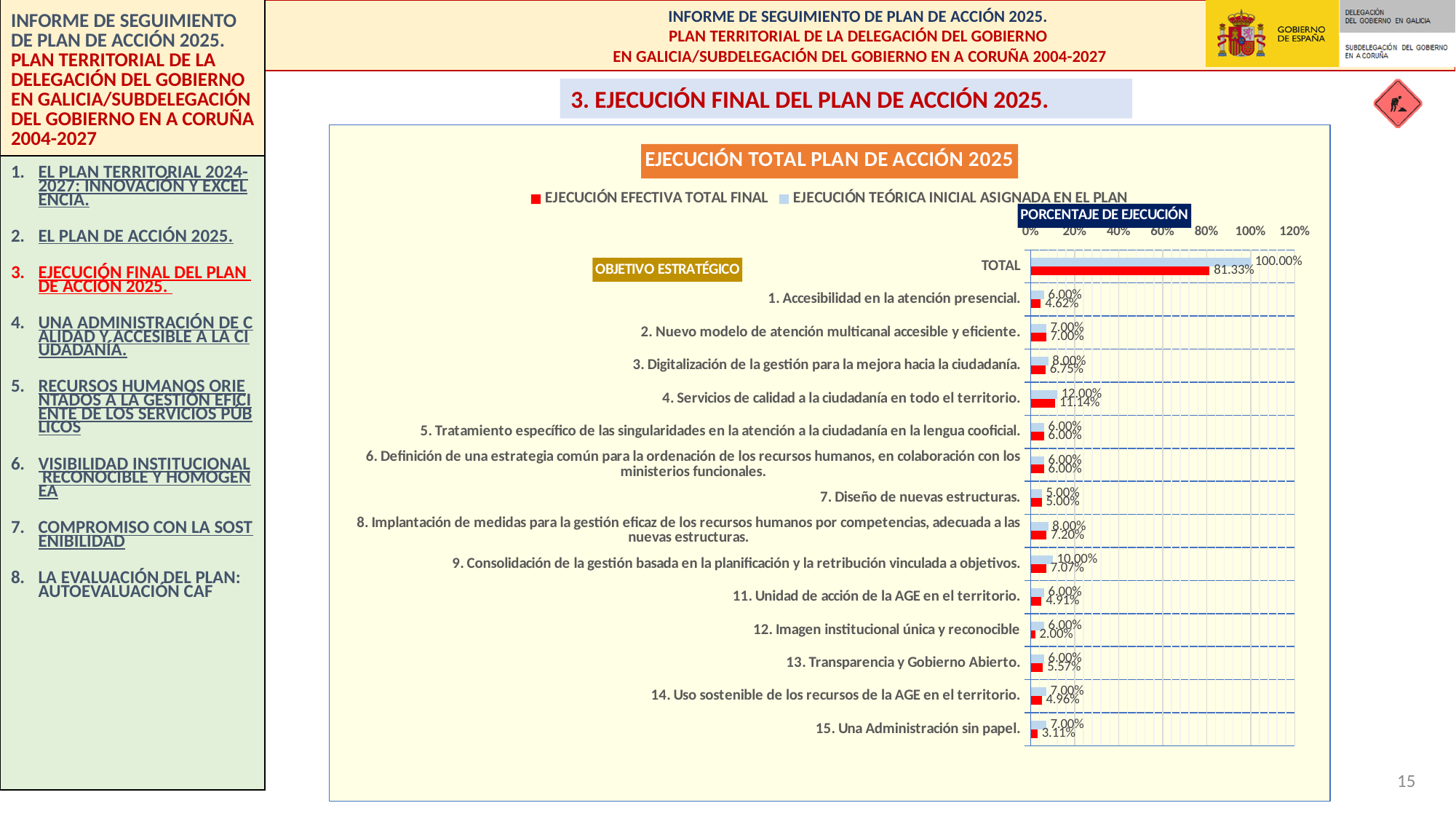
What is the difference between the EJECUCIÓN TEÓRICA INICIAL and the EJECUCIÓN EFECTIVA TOTAL FINAL for '9. Consolidación de la gestión basada en la planificación y la retribución vinculada a objetivos.'? 2.93% How many series does the legend list? 2 What is the value of EJECUCIÓN EFECTIVA TOTAL FINAL for '12. Imagen institucional única y reconocible'? 2.00% Which is larger for '14. Uso sostenible de los recursos de la AGE en el territorio.': the EJECUCIÓN TEÓRICA INICIAL or the EJECUCIÓN EFECTIVA TOTAL FINAL? EJECUCIÓN TEÓRICA INICIAL What is the value of EJECUCIÓN EFECTIVA TOTAL FINAL for '15. Una Administración sin papel.'? 3.11% Is the EJECUCIÓN EFECTIVA TOTAL FINAL value for TOTAL greater or less than 60%? greater What is the value of EJECUCIÓN TEÓRICA INICIAL ASIGNADA EN EL PLAN for '4. Servicios de calidad a la ciudadanía en todo el territorio.'? 12.00% What is the value of EJECUCIÓN EFECTIVA TOTAL FINAL for TOTAL? 81.33% How many categories (including TOTAL) are shown on the chart? 15 What kind of chart is shown on the slide? Bar chart Excluding TOTAL, which objective has the lowest EJECUCIÓN EFECTIVA TOTAL FINAL value? 12. Imagen institucional única y reconocible Excluding TOTAL, which objective has the highest EJECUCIÓN EFECTIVA TOTAL FINAL value? 4. Servicios de calidad a la ciudadanía en todo el territorio.